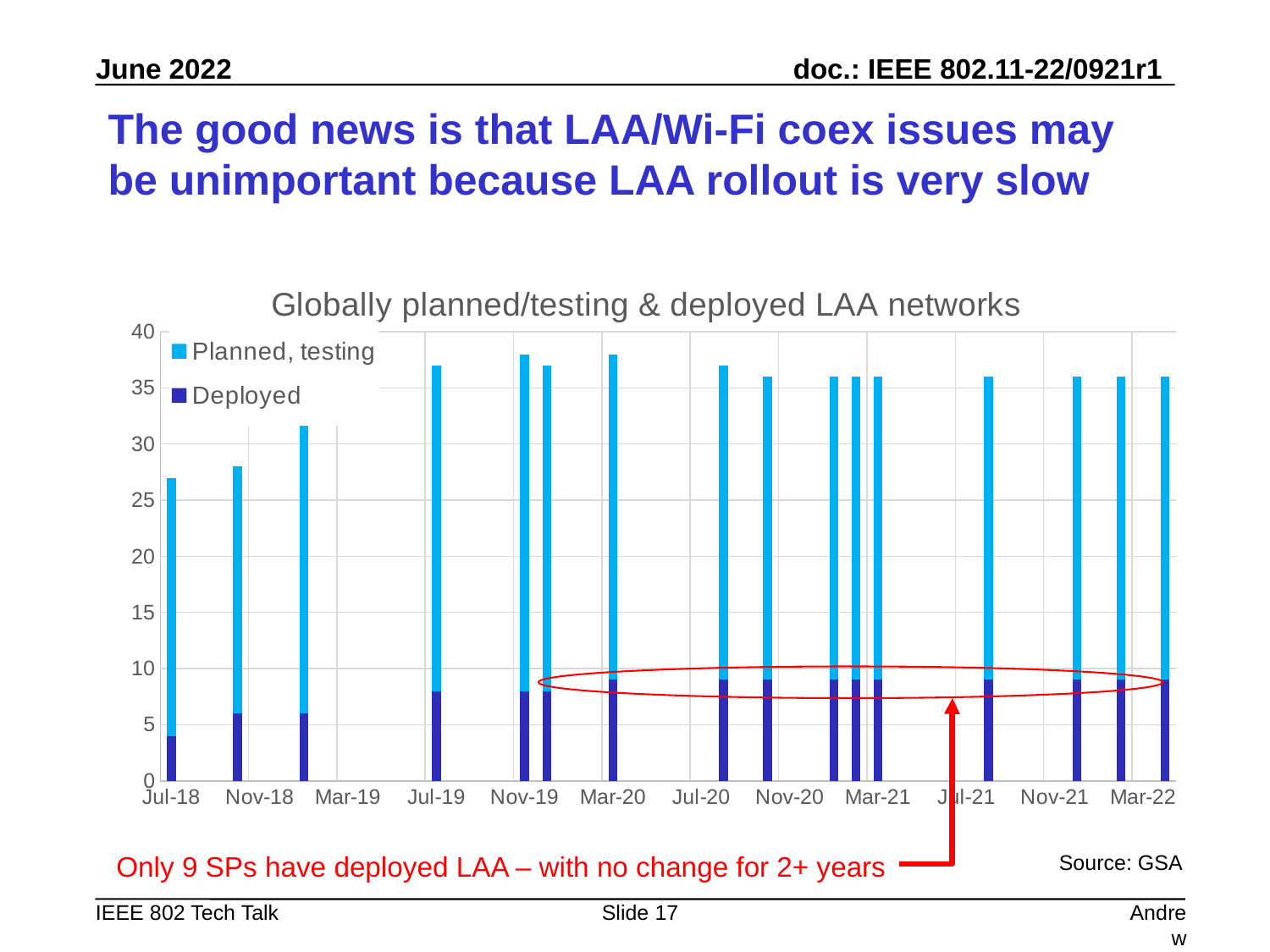
Is the total height of the Nov-18 bar greater or less than 30? less What kind of chart is shown on the slide? Stacked bar chart Which series is shown in dark blue in the chart? Deployed How many series does the chart legend list? 2 Is the Deployed value for Mar-20 greater or less than 10? less Which has the larger Deployed value, Jul-18 or Jul-19? Jul-19 Is the total height of the Jul-19 bar greater or less than 35? greater Which bar has the larger total, Jul-18 or Jul-19? Jul-19 What is the title of the chart? Globally planned/testing & deployed LAA networks Does the Deployed series rise or fall from Jul-18 to Jul-19? rise